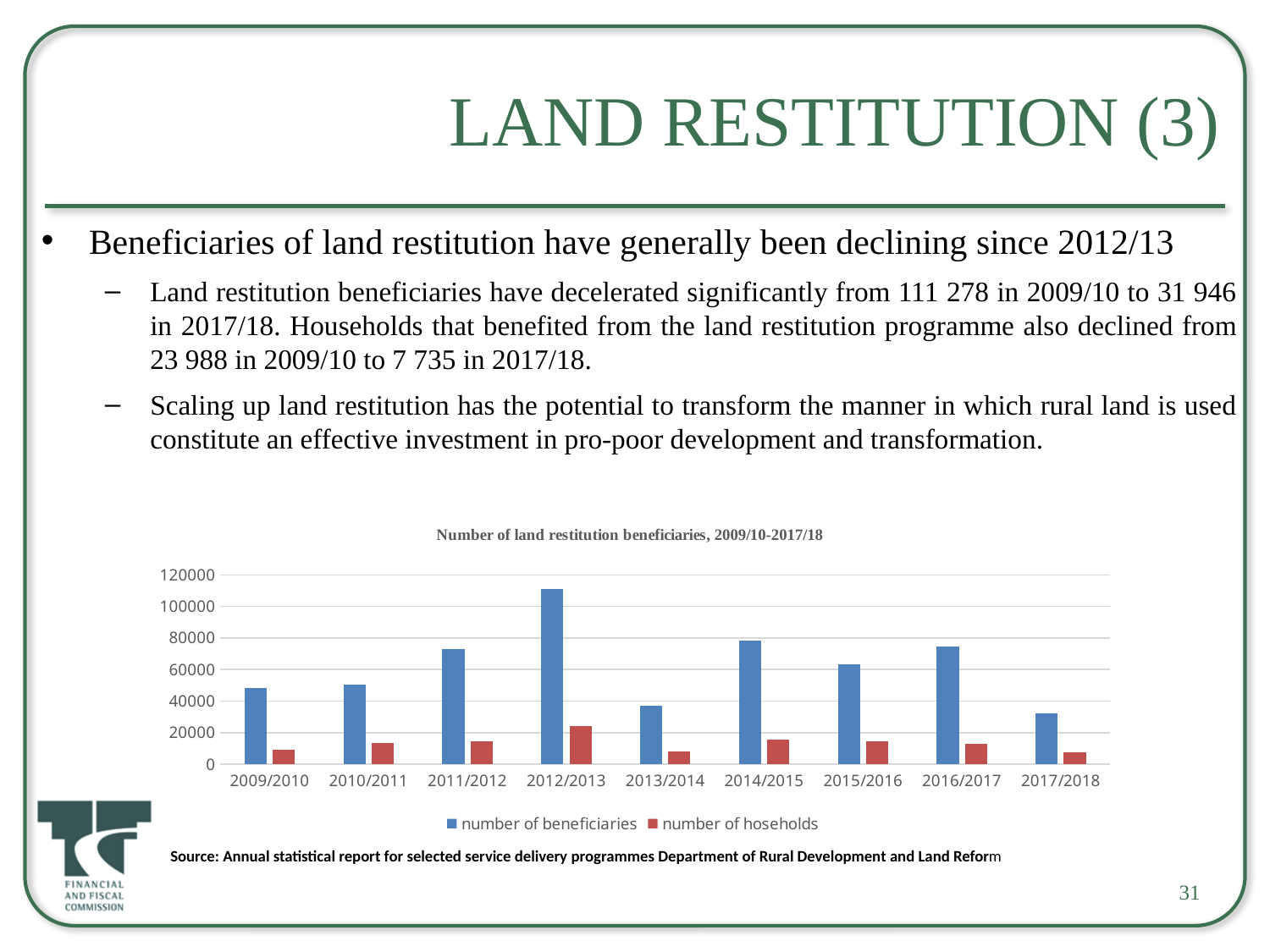
What type of chart is shown on the slide? bar chart Which series is shown in red in the chart? number of hoseholds Is the number of beneficiaries in 2013/2014 greater or less than 40000? less In which year is the number of beneficiaries lowest? 2017/2018 Which year has more beneficiaries, 2011/2012 or 2015/2016? 2011/2012 What is the title of the chart? Number of land restitution beneficiaries, 2009/10-2017/18 How many series does the chart legend list? 2 In which year is the number of households highest? 2012/2013 In which year is the number of beneficiaries highest? 2012/2013 Is the number of beneficiaries in 2012/2013 greater or less than 100000? greater Is the number of households in 2012/2013 greater or less than 20000? greater How many financial years are shown on the x axis of the chart? 9